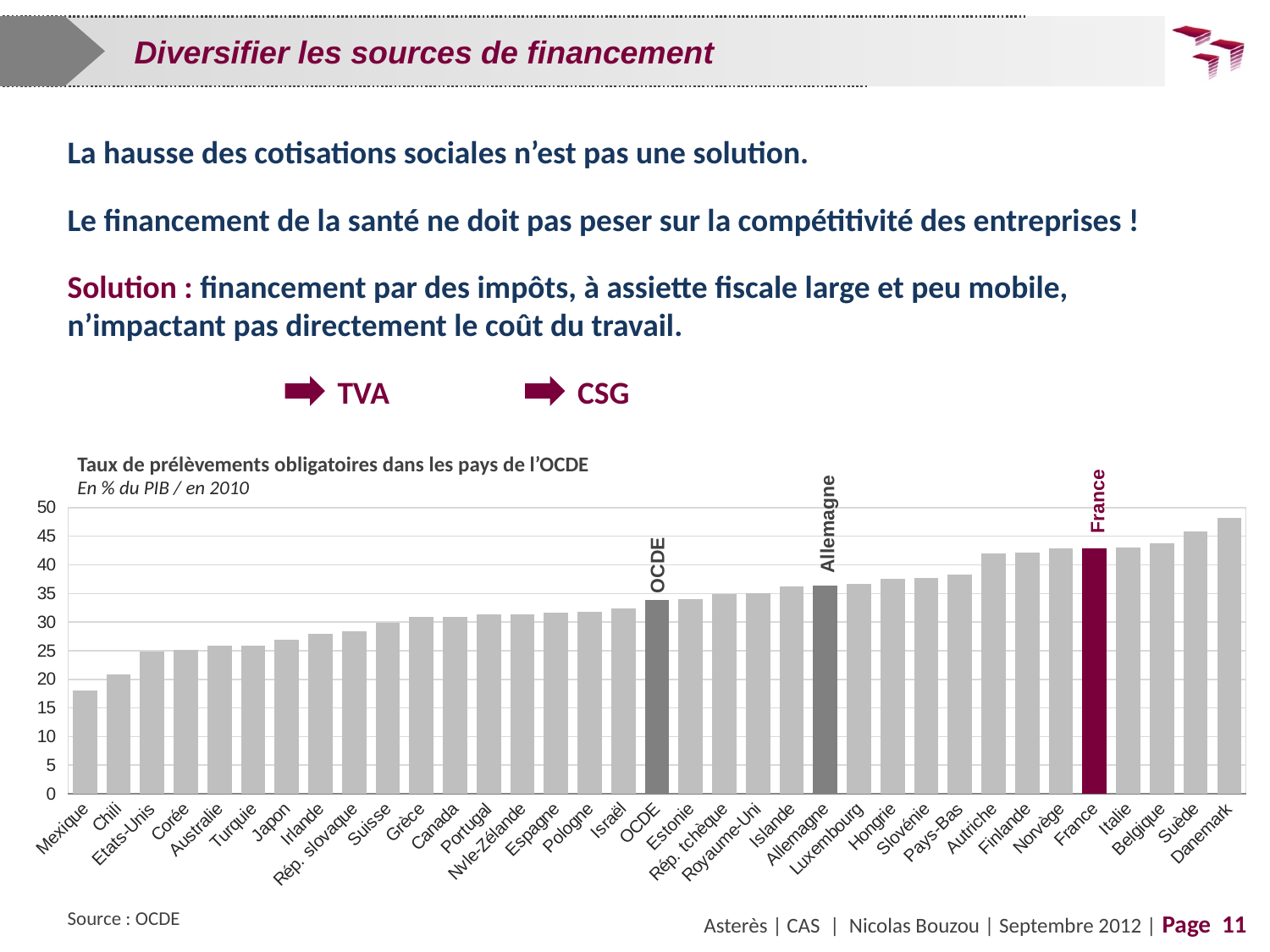
Which has a larger value, France or Allemagne? France Is the value for Japon greater or less than 30? less What is the title of the chart? Taux de prélèvements obligatoires dans les pays de l'OCDE Is the value for Allemagne greater or less than 40? less How many bars (categories) are plotted in the chart? 35 Which country has the lowest value in the chart? Mexique Is the value for France greater or less than 40? greater Do the values rise or fall from left to right along the x axis? rise What kind of chart is shown on the slide? bar chart Which country has the highest value in the chart? Danemark